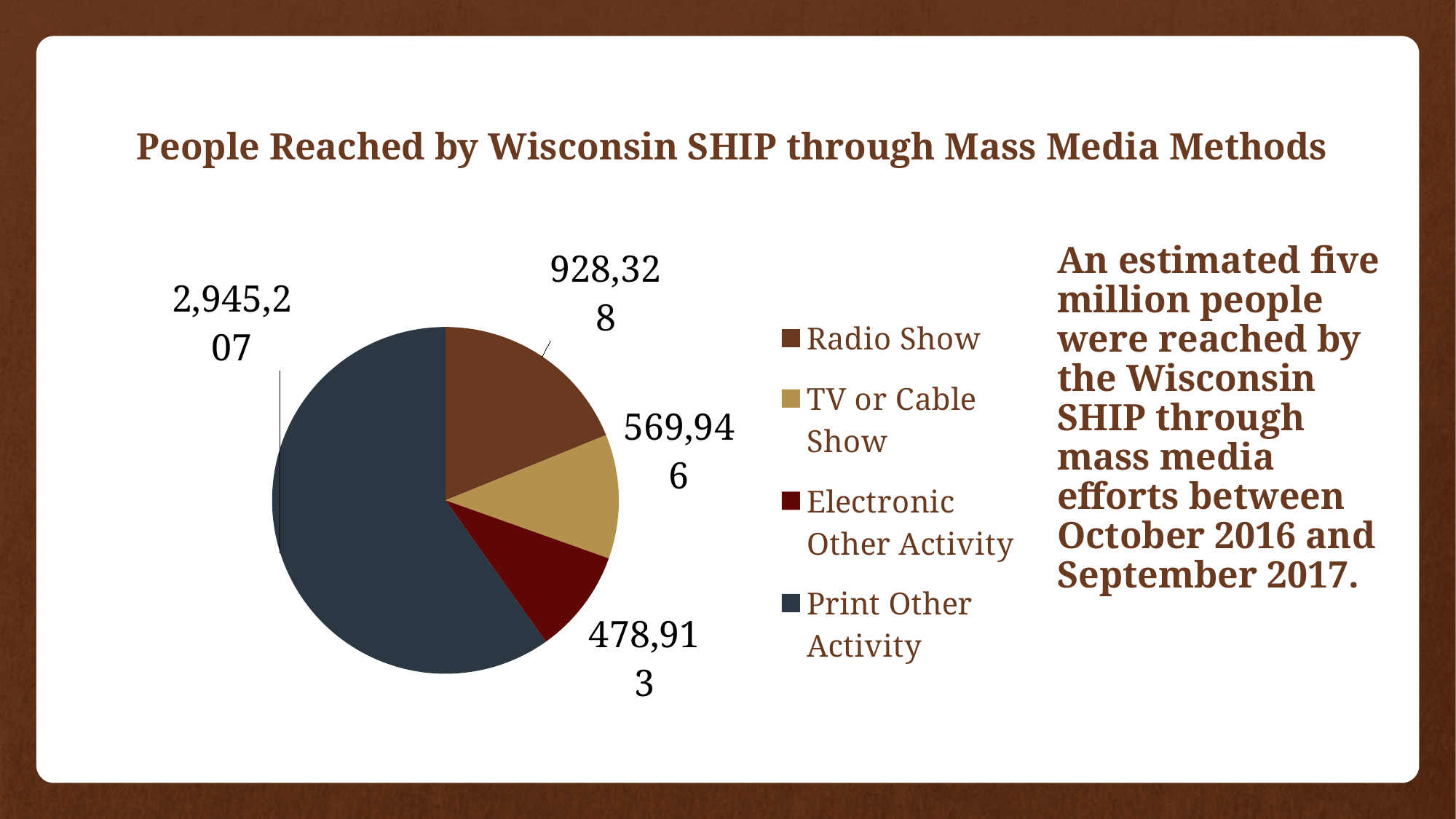
How many entries does the legend list? 4 How many slices does the pie chart have? 4 How many people were reached through Radio Show? 928,328 What kind of chart is shown on the slide? Pie chart Which category reached the most people? Print Other Activity Which is larger, Radio Show or TV or Cable Show? Radio Show Which category reached the fewest people? Electronic Other Activity What is the value for Print Other Activity? 2,945,207 What is the value for Electronic Other Activity? 478,913 What is the value for TV or Cable Show? 569,946 What is the title of the pie chart? People Reached by Wisconsin SHIP through Mass Media Methods What is the difference between Print Other Activity and Radio Show? 2,016,879